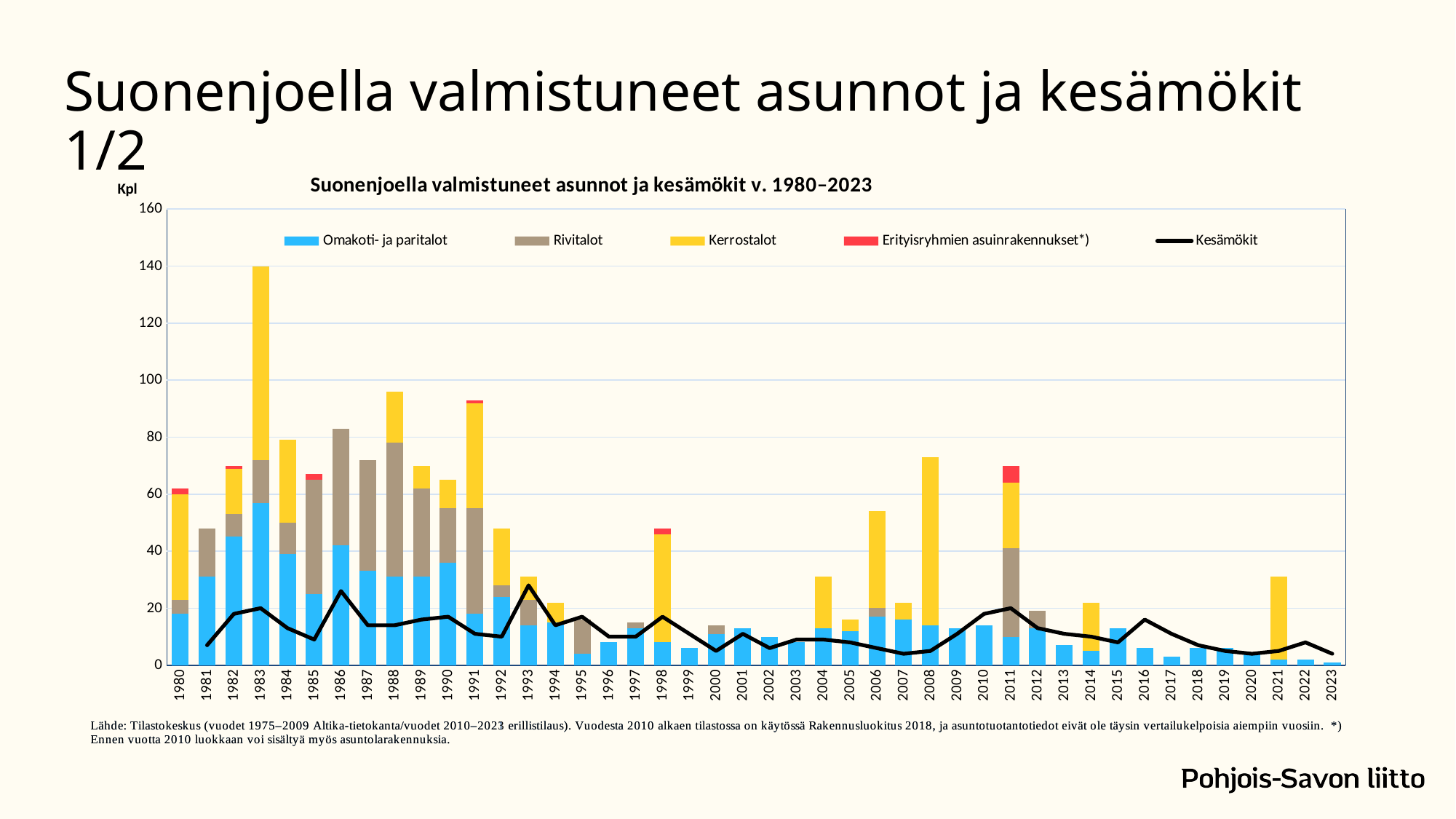
Which colour represents Kerrostalot in the chart legend? Yellow Which year has the shortest stacked bar in the chart? 2023 Which year has the tallest stacked bar in the chart? 1983 How many years are shown along the x axis of the chart? 44 Is the total stacked bar for 1999 greater or less than 20? less Which year has the larger total stacked bar, 2006 or 2008? 2008 Is the total stacked bar for 2008 greater or less than 60? greater Is the Kesämökit line value for 1993 greater or less than 20? greater What kind of chart is shown on the slide? Stacked bar chart with a line Do the stacked bar totals generally rise or fall from the 1980s to the 2020s? fall How many series does the chart legend list? 5